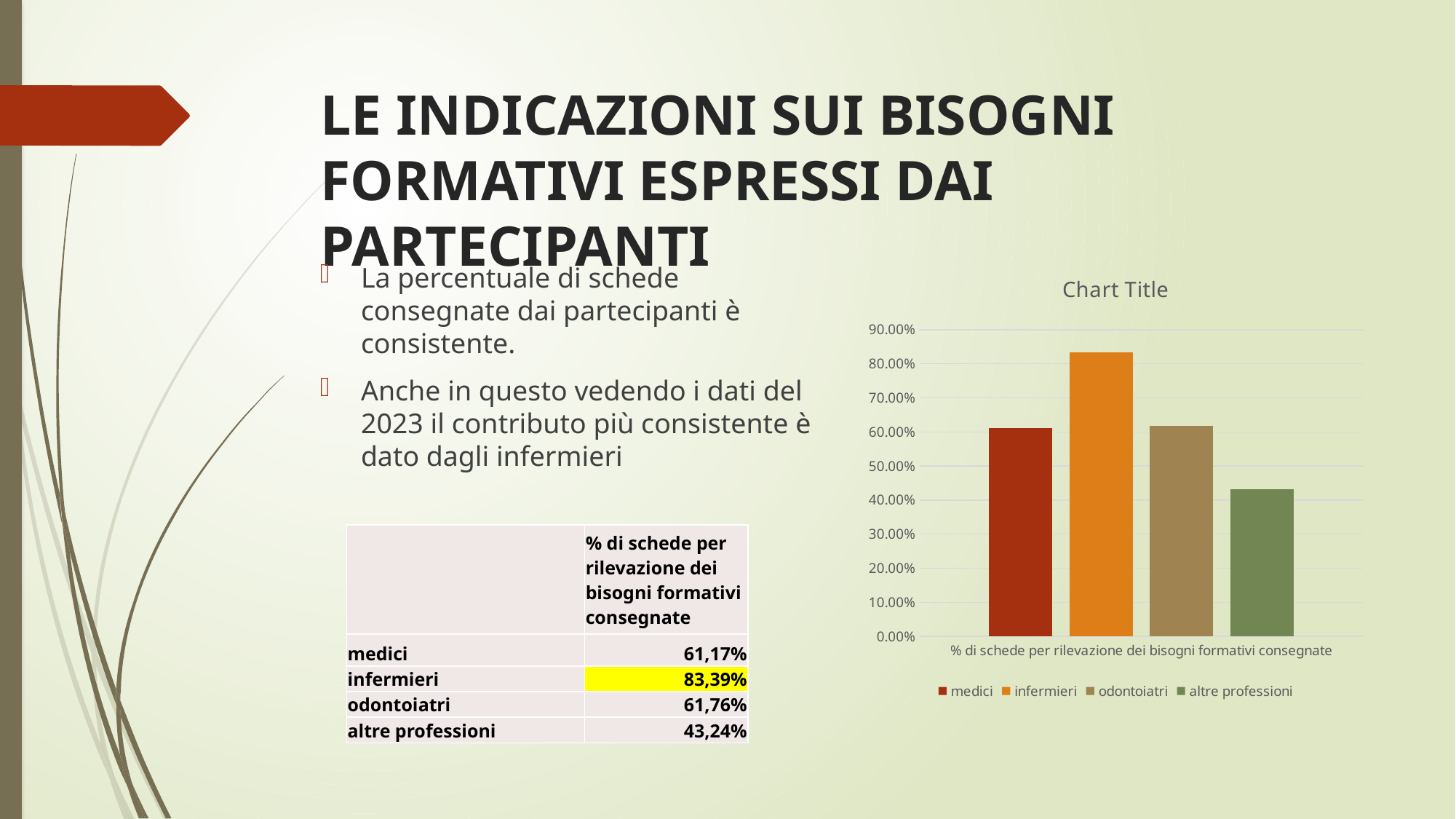
Which series has the lowest bar in the chart? altre professioni What is the title shown above the chart? Chart Title Which series has the highest bar in the chart? infermieri Is the value for altre professioni greater or less than 50.00%? less Is the value for infermieri greater or less than 80.00%? greater According to the table on the slide, what is the percentage of schede consegnate for altre professioni? 43,24% How many series does the chart legend list? 4 According to the table on the slide, what is the percentage of schede consegnate for infermieri? 83,39% How many bars are plotted in the chart? 4 Is the value for medici greater or less than 60.00%? greater What kind of chart is shown on the slide? bar chart Which is larger, the bar for infermieri or the bar for odontoiatri? infermieri